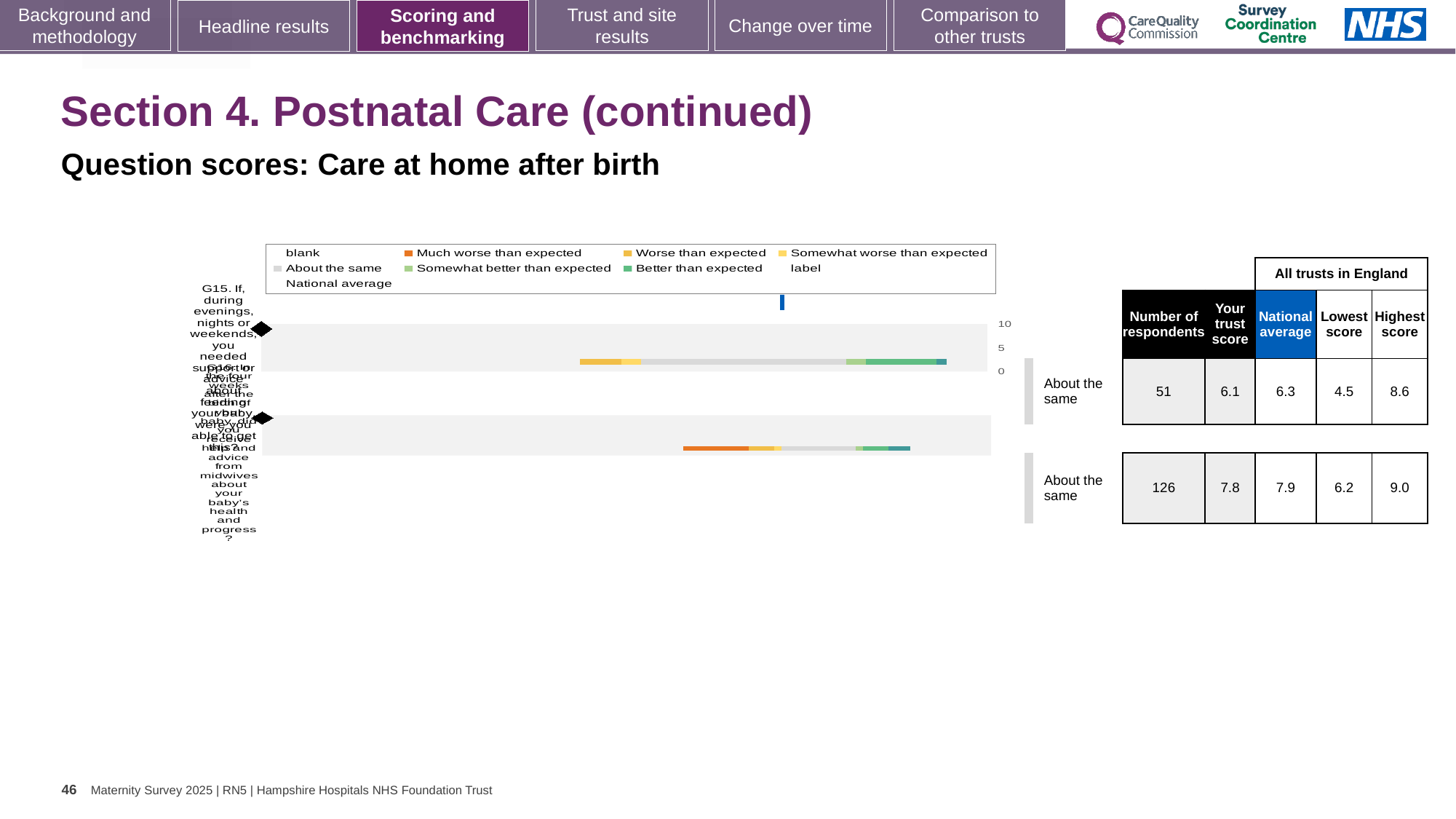
Which row has the larger trust score, the top row or the bottom row? bottom row What is the difference between the highest score and the lowest score for the top row? 4.1 Which row has more respondents? bottom row (126) How many question rows (bars) does the chart show? 2 What is the trust score for the top row of the chart? 6.1 What benchmark category is shown for both rows of the chart? About the same What is the national average for the bottom row of the chart? 7.9 What kind of chart is shown on the slide? bar chart For the bottom row, how much higher is the national average than the trust score? 0.1 In the table beside the chart, what is the number of respondents for the top row? 51 What is the highest score among all trusts in England for the bottom row? 9.0 What colour represents 'Much worse than expected' in the legend? orange